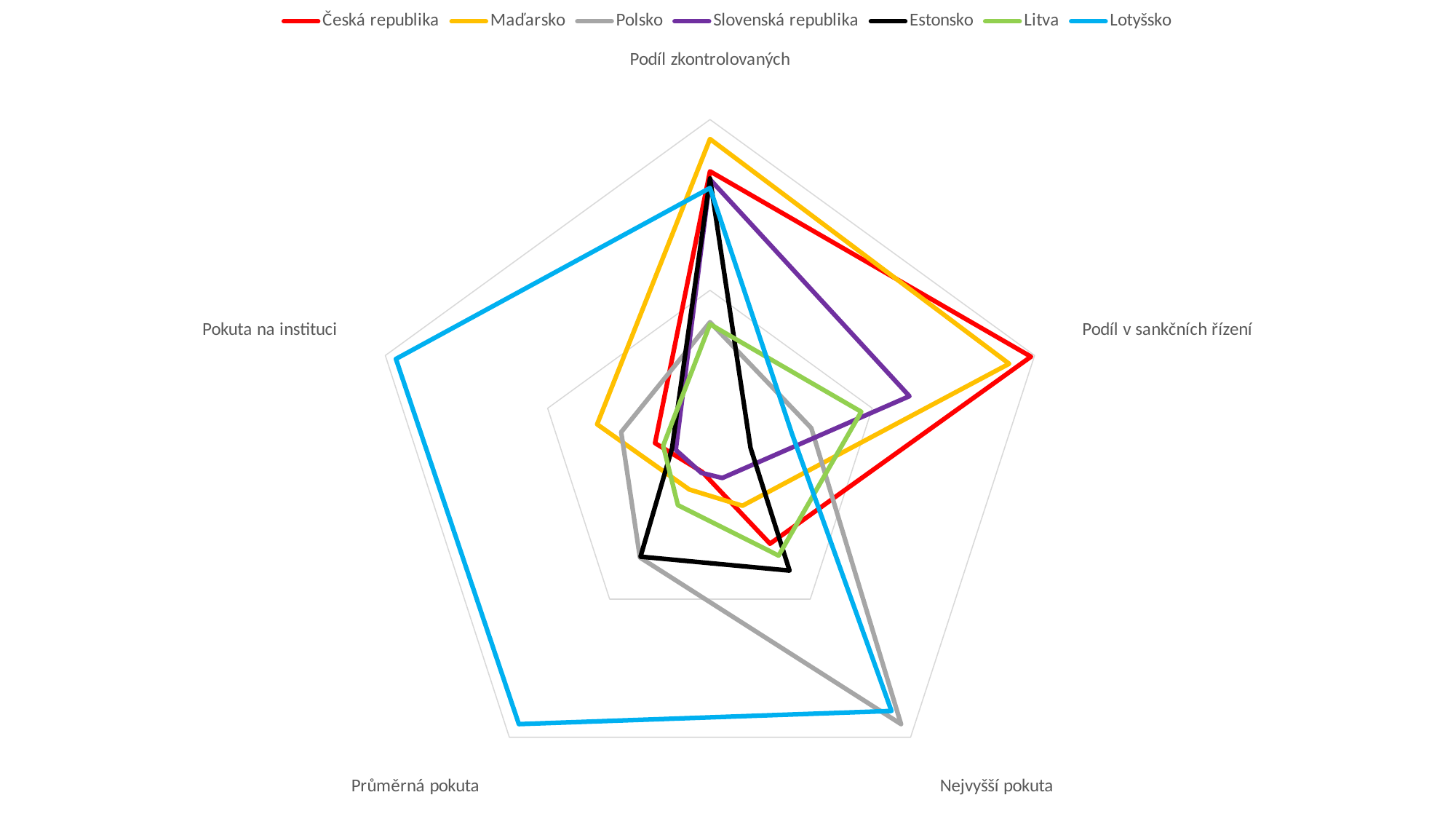
Which country has the highest value for Pokuta na instituci? Lotyšsko Which country has the highest value for Podíl v sankčních řízení? Česká republika Which country has the highest value for Průměrná pokuta? Lotyšsko For Podíl zkontrolovaných, which is larger: Maďarsko or Litva? Maďarsko Which country has the lowest value for Nejvyšší pokuta? Slovenská republika For Nejvyšší pokuta, which is larger: Polsko or Estonsko? Polsko Which colour represents Lotyšsko in the legend? Light blue Which country has the lowest value for Podíl v sankčních řízení? Estonsko How many series does the legend list? 7 What kind of chart is shown on the slide? Radar chart How many axes (categories) does the radar chart have? 5